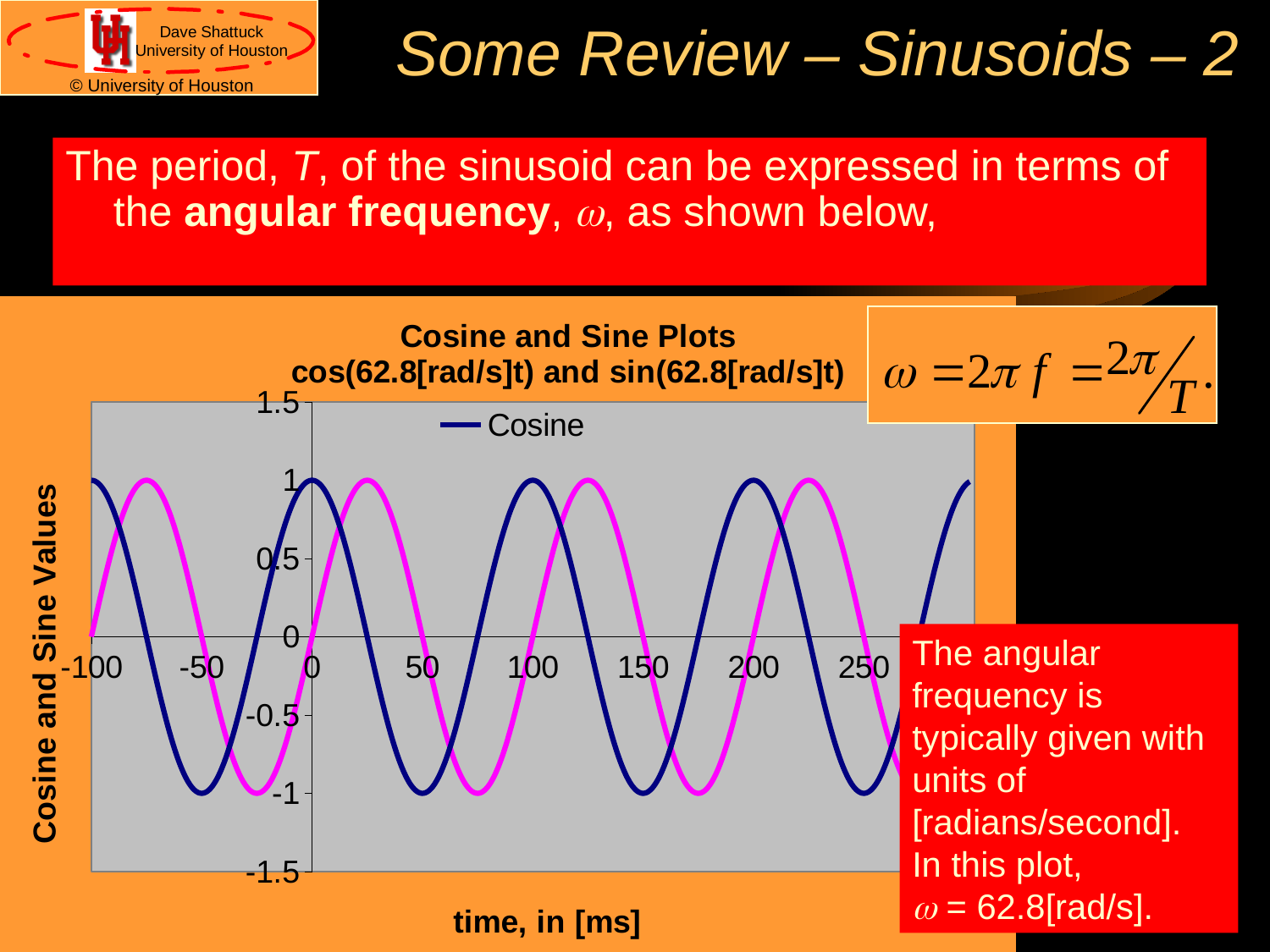
What colour is the Cosine curve on the chart? dark blue What is the value of the Cosine curve at time 0 ms? 1 What is the label of the x axis of the chart? time, in [ms] What is the value of the Cosine curve at time -50 ms? -1 What is the value of the sine curve at time 0 ms? 0 Is the value of the Cosine curve at time 150 ms greater or less than -0.5? less Is the value of the Cosine curve at time 0 ms greater or less than 0.5? greater What is the value of the Cosine curve at time 50 ms? -1 At time 0 ms, which curve has the larger value, the Cosine curve or the sine curve? Cosine How many curves are plotted on the chart? 2 What kind of chart is shown on the slide? line chart What is the value of the Cosine curve at time 100 ms? 1